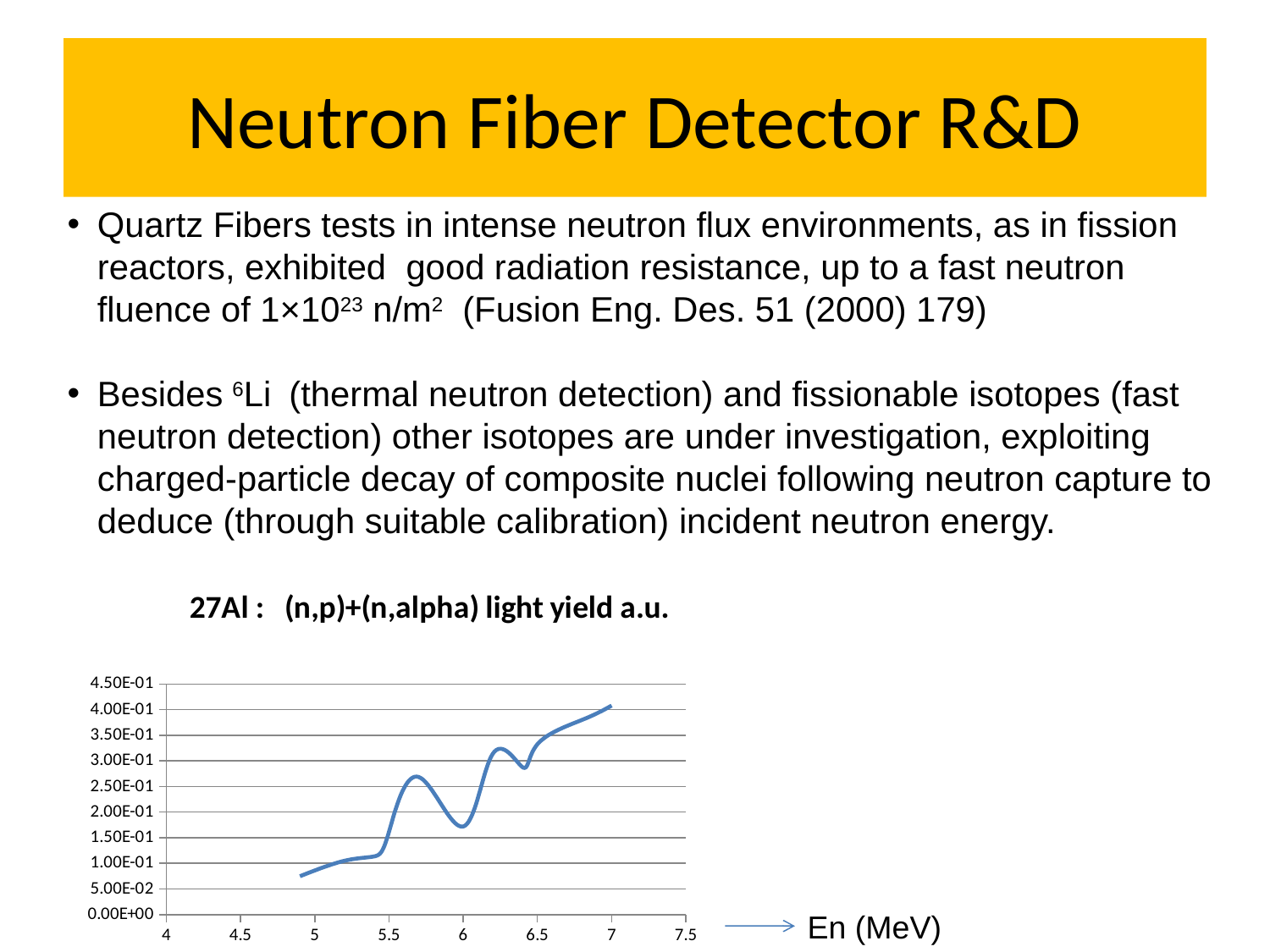
Which has the larger light yield, En = 7 MeV or En = 5 MeV? En = 7 MeV What is the title of the chart? 27Al : (n,p)+(n,alpha) light yield a.u. What quantity is labelled on the x axis of the chart? En (MeV) What is the highest value shown on the y axis of the chart? 4.50E-01 Is the light yield at En = 5 MeV greater or less than 1.50E-01? less Is the light yield at En = 6 MeV greater or less than 2.50E-01? less Overall, does the light yield rise or fall as En increases from about 5 to 7 MeV? rise Is the light yield at En = 7 MeV greater or less than 3.50E-01? greater What kind of chart is shown on the slide? line chart Which has the larger light yield, En = 6 MeV or En = 6.5 MeV? En = 6.5 MeV